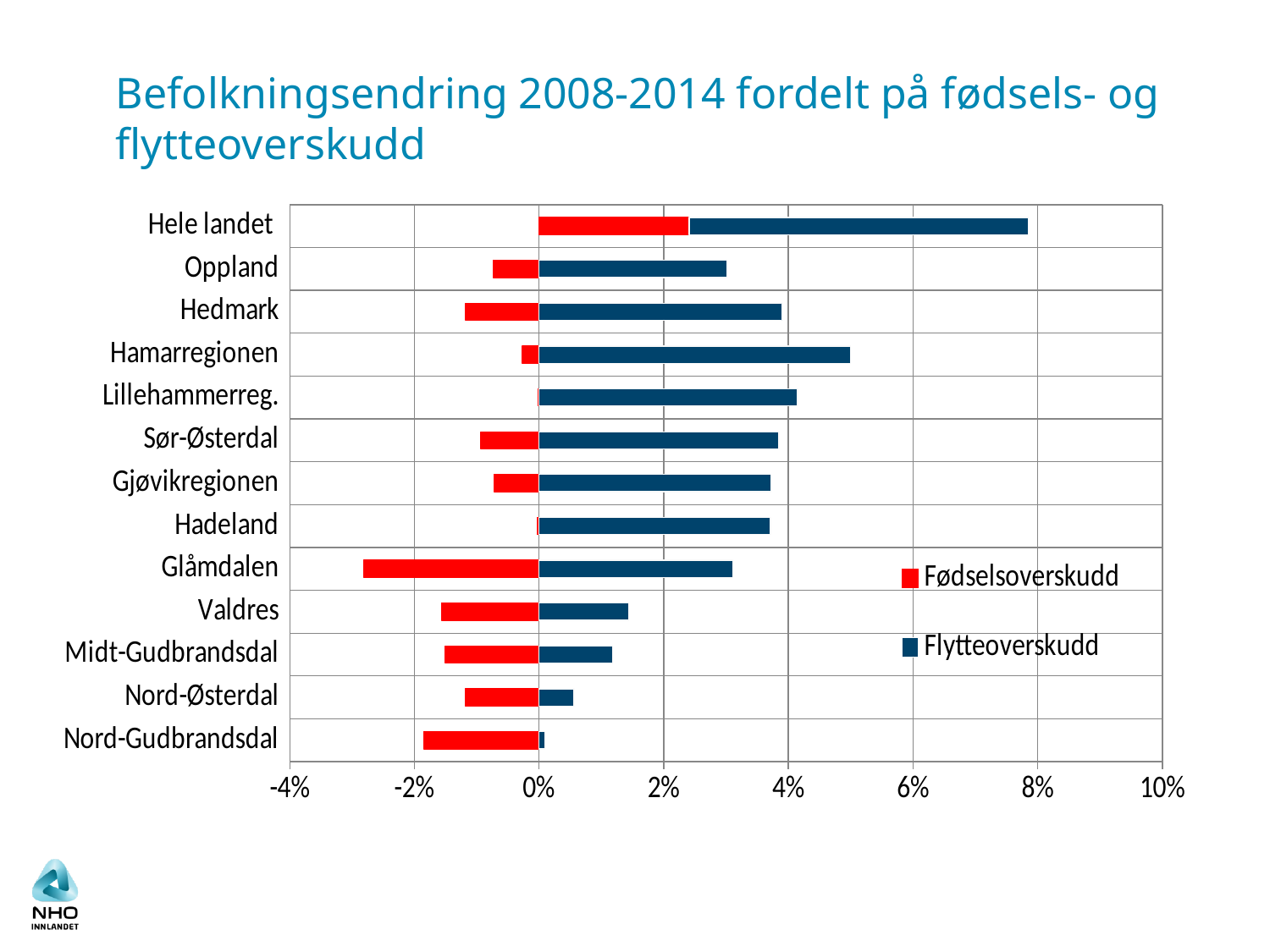
Which has the larger Flytteoverskudd, Hamarregionen or Oppland? Hamarregionen What kind of chart is shown on the slide? Bar chart Which series is shown in red in the chart? Fødselsoverskudd What is the title of the slide? Befolkningsendring 2008-2014 fordelt på fødsels- og flytteoverskudd Which is the only category with a positive Fødselsoverskudd? Hele landet How many categories are shown on the vertical axis of the chart? 13 Is the Flytteoverskudd value for Hamarregionen greater or less than 4%? greater Which category has the most negative Fødselsoverskudd? Glåmdalen Is the Fødselsoverskudd value for Glåmdalen greater or less than -2%? less Is the Flytteoverskudd value for Nord-Østerdal greater or less than 2%? less Which category has the smallest Flytteoverskudd? Nord-Gudbrandsdal How many series does the legend list? 2